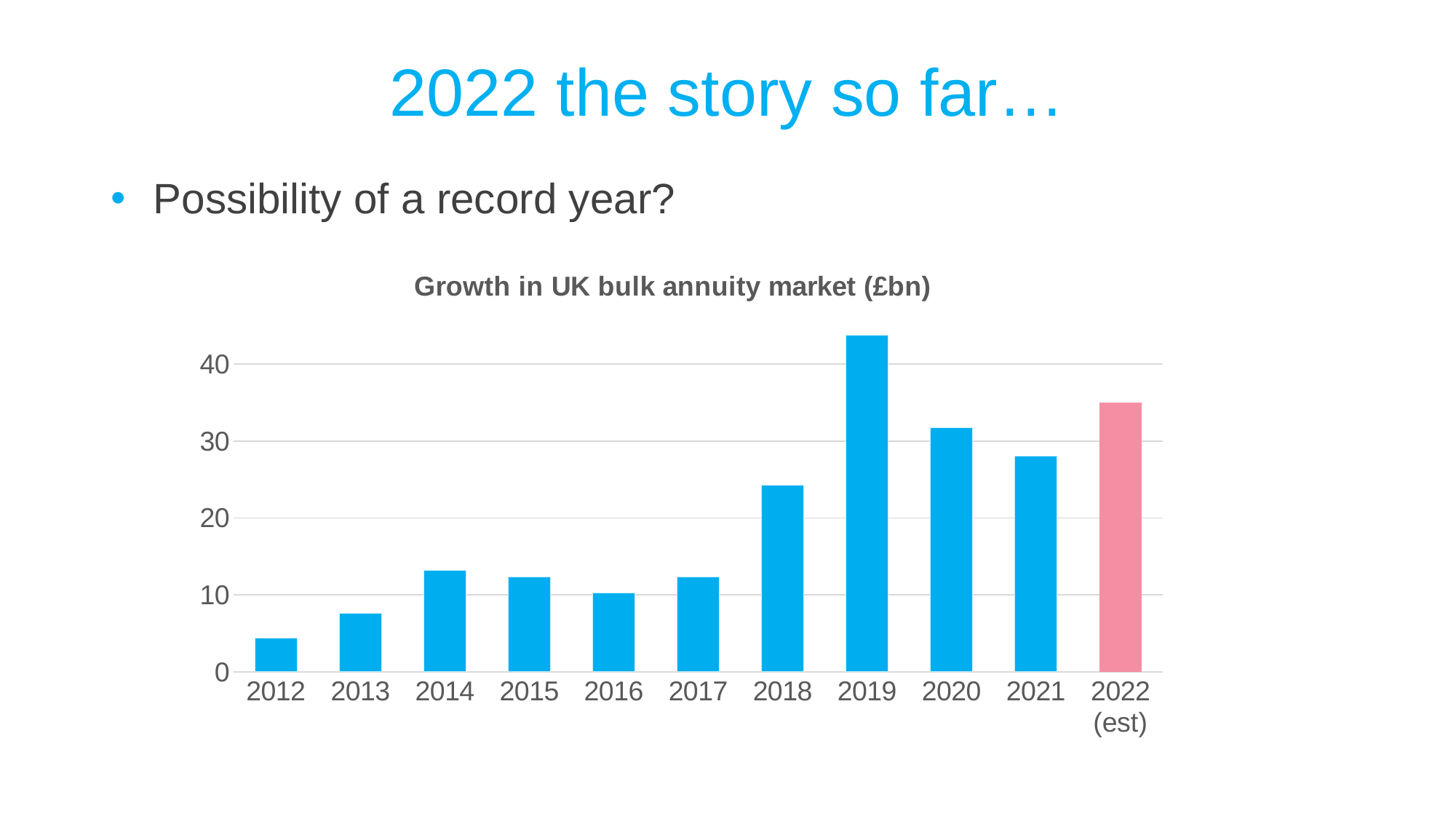
Which is larger, the value for 2019 or the value for 2022 (est)? 2019 Which is larger, the value for 2020 or the value for 2021? 2020 How many years (bars) are shown on the chart? 11 What is the title of the chart? Growth in UK bulk annuity market (£bn) Which bar is shown in a different colour (pink) from the others? 2022 (est) What type of chart is shown on the slide? Bar chart Is the value for 2022 (est) greater or less than 30? greater Is the value for 2019 greater or less than 40? greater Which year has the highest value on the chart? 2019 Is the value for 2013 greater or less than 10? less Which year has the lowest value on the chart? 2012